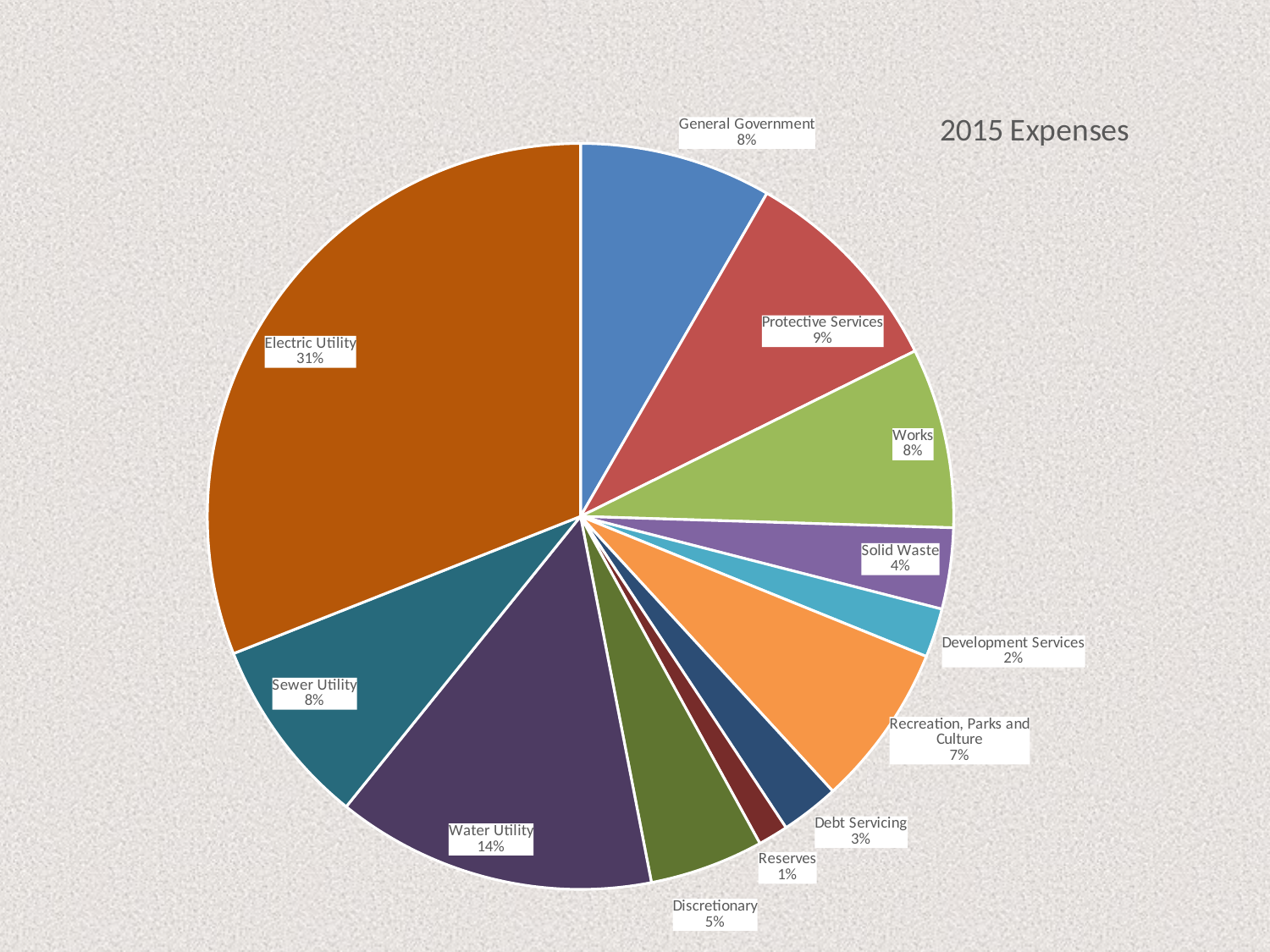
What share of 2015 expenses is Electric Utility? 31% Which category has the smallest share of 2015 expenses? Reserves How many categories are shown in the pie chart? 12 What type of chart is shown on the slide? pie chart What percentage is shown for Water Utility? 14% What is the combined share of Sewer Utility and Water Utility? 22% Which category has the largest share of 2015 expenses? Electric Utility Which is larger, the share for Solid Waste or the share for Debt Servicing? Solid Waste What is the title of the chart? 2015 Expenses What is the difference in percentage points between Electric Utility and Water Utility? 17 What percentage is shown for Protective Services? 9% What percentage is shown for Recreation, Parks and Culture? 7%